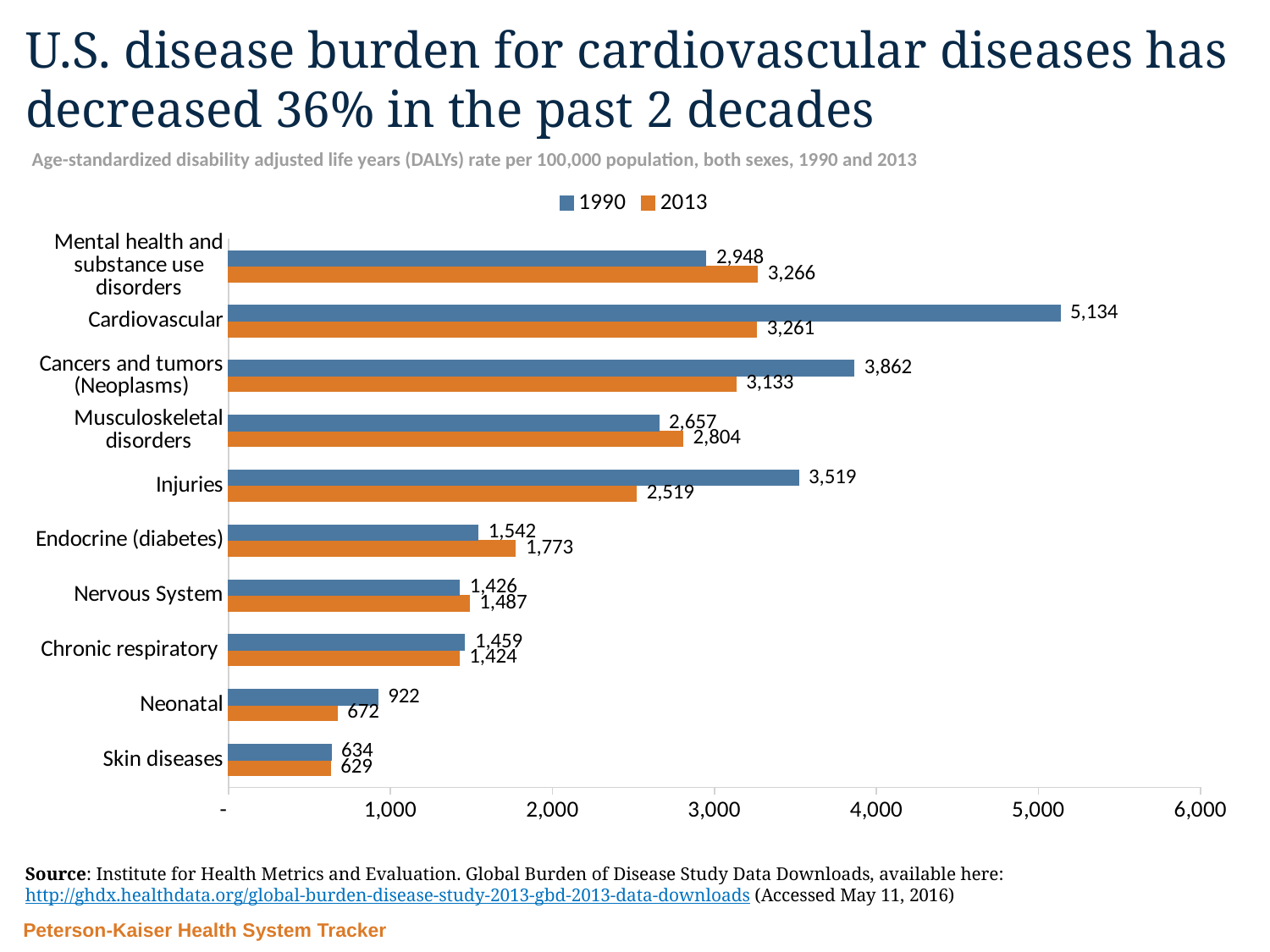
What was the 1990 DALY rate for Cardiovascular? 5,134 What was the 2013 value for Mental health and substance use disorders? 3,266 What was the 2013 DALY rate for Injuries? 2,519 What type of chart is shown on the slide? Bar chart Which category had the lowest 2013 value? Skin diseases Which category had the highest 1990 value? Cardiovascular What is the difference between the 1990 and 2013 values for Cardiovascular? 1,873 How many disease categories are shown in the chart? 10 Which is larger for Endocrine (diabetes): the 1990 value or the 2013 value? 2013 Is the 1990 value for Cancers and tumors (Neoplasms) greater or less than 3,000? greater What is the difference between the 1990 and 2013 values for Neonatal? 250 How many series does the legend list? 2